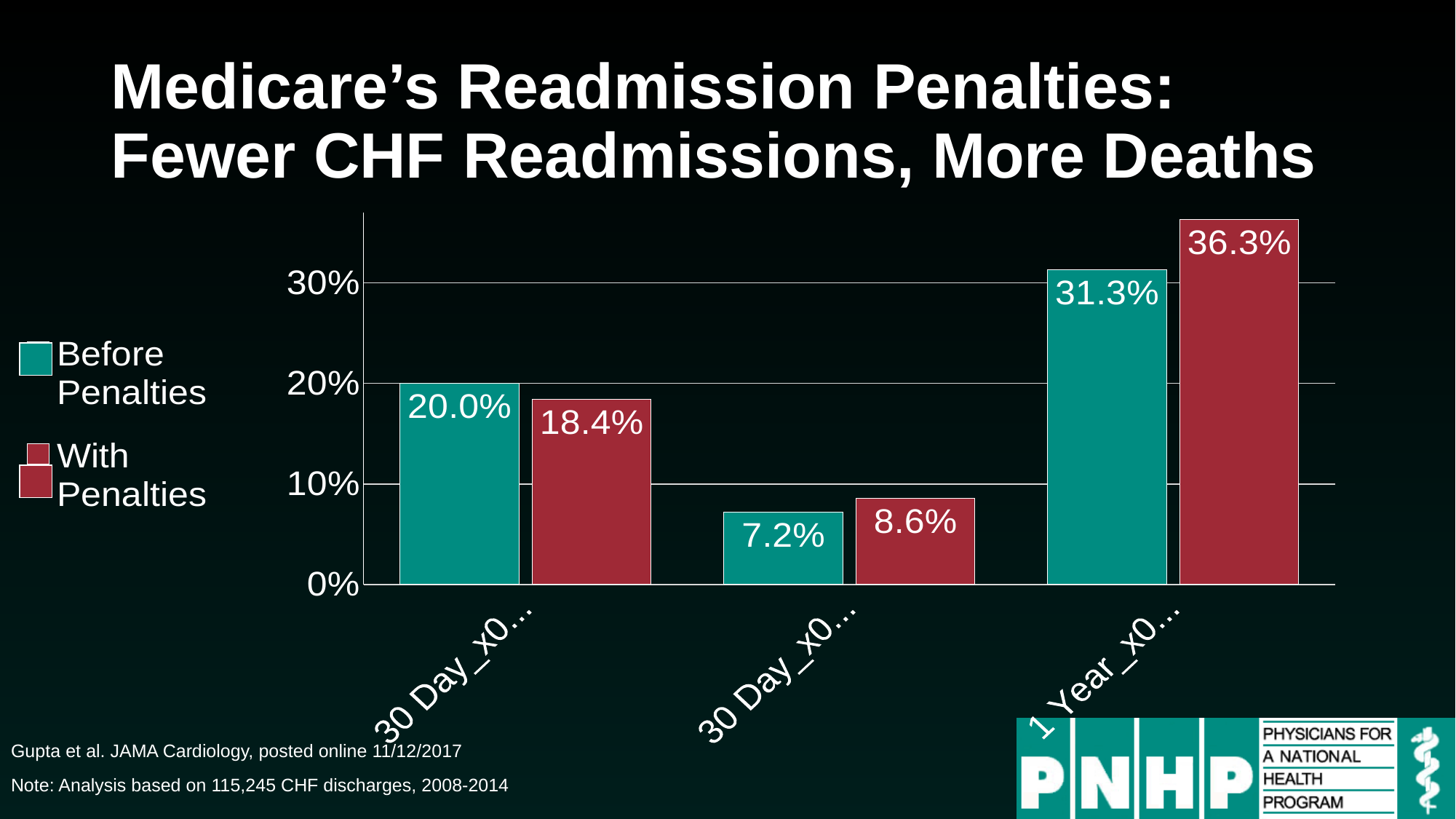
In the rightmost group, how much higher is the With Penalties value than the Before Penalties value? 5.0 percentage points What is the lowest value shown on the chart? 7.2% How many category groups are plotted along the x axis? 3 What is the With Penalties value in the middle group of bars? 8.6% What kind of chart is shown on the slide? Bar chart What is the highest value shown on the chart? 36.3% What is the With Penalties value in the rightmost group of bars? 36.3% In the middle group of bars, which series has the larger value, Before Penalties or With Penalties? With Penalties How many series does the chart's legend list? 2 Which legend entry is shown in teal? Before Penalties What is the Before Penalties value in the leftmost group of bars? 20.0% In the leftmost group, how much higher is the Before Penalties value than the With Penalties value? 1.6 percentage points